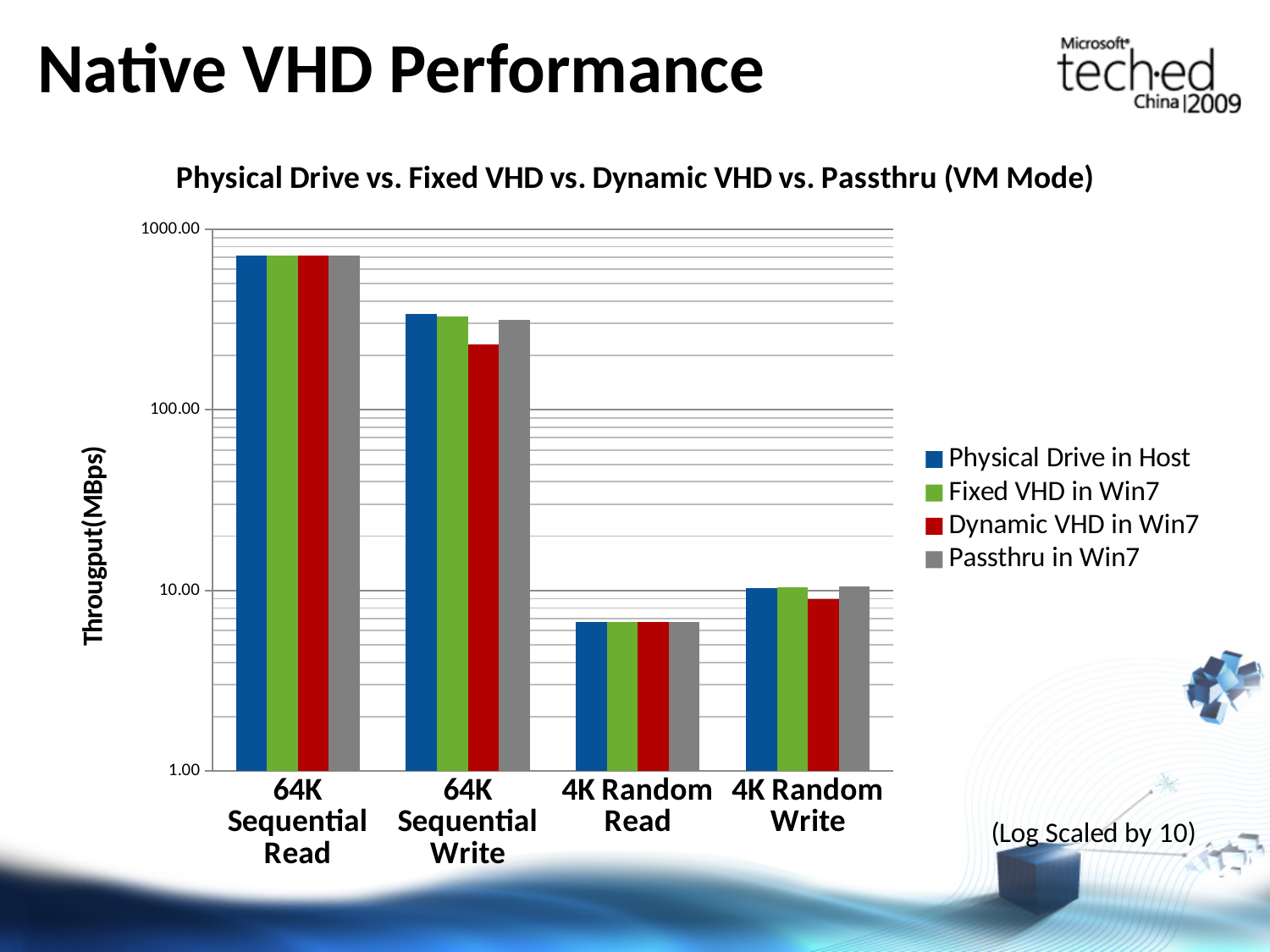
How many categories are shown on the x axis of the chart? 4 What is the title of the chart? Physical Drive vs. Fixed VHD vs. Dynamic VHD vs. Passthru (VM Mode) For the Physical Drive in Host series, which category has the highest throughput? 64K Sequential Read How many series does the chart's legend list? 4 In the 64K Sequential Write category, which is larger: Fixed VHD in Win7 or Dynamic VHD in Win7? Fixed VHD in Win7 What kind of chart is shown on the slide? bar chart For Passthru in Win7, which is larger: 64K Sequential Read or 64K Sequential Write? 64K Sequential Read Is the value for Physical Drive in Host at 64K Sequential Read greater or less than 100.00? greater Is the value for Fixed VHD in Win7 at 4K Random Read greater or less than 10.00? less For the Passthru in Win7 series, which category has the lowest throughput? 4K Random Read Is the value for Dynamic VHD in Win7 at 64K Sequential Write greater or less than 100.00? greater What is the label on the chart's vertical axis? Througput(MBps)